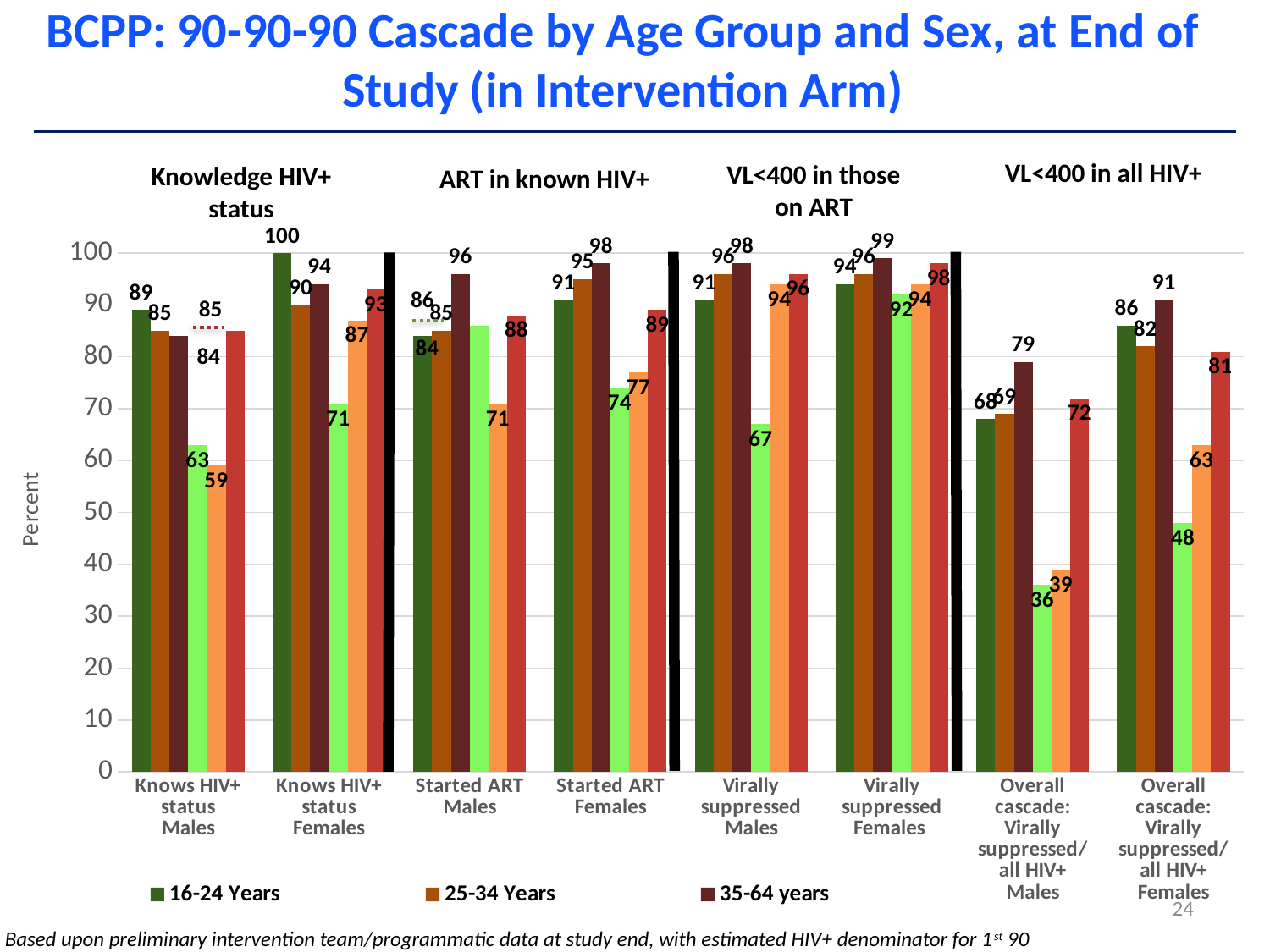
Which category has the highest value for 16-24 Years? Knows HIV+ status Females What is the difference between the 16-24 Years values for Knows HIV+ status Females and Knows HIV+ status Males? 11 For 35-64 years, which is larger: Overall cascade Females or Overall cascade Males? Overall cascade Females How many categories are shown on the x axis? 8 What is the value for 35-64 years in the Virally suppressed Females category? 99 Is the value for 25-34 Years in the Overall cascade Males category greater or less than 80? less What is the value for 25-34 Years in the Overall cascade: Virally suppressed/all HIV+ Males category? 69 How many series does the legend list? 3 What is the value for 16-24 Years in the Started ART Females category? 91 What is the value for 35-64 years in the Overall cascade: Virally suppressed/all HIV+ Females category? 91 Which category has the lowest value for 35-64 years? Overall cascade: Virally suppressed/all HIV+ Males What is the value for 16-24 Years in the Knows HIV+ status Females category? 100